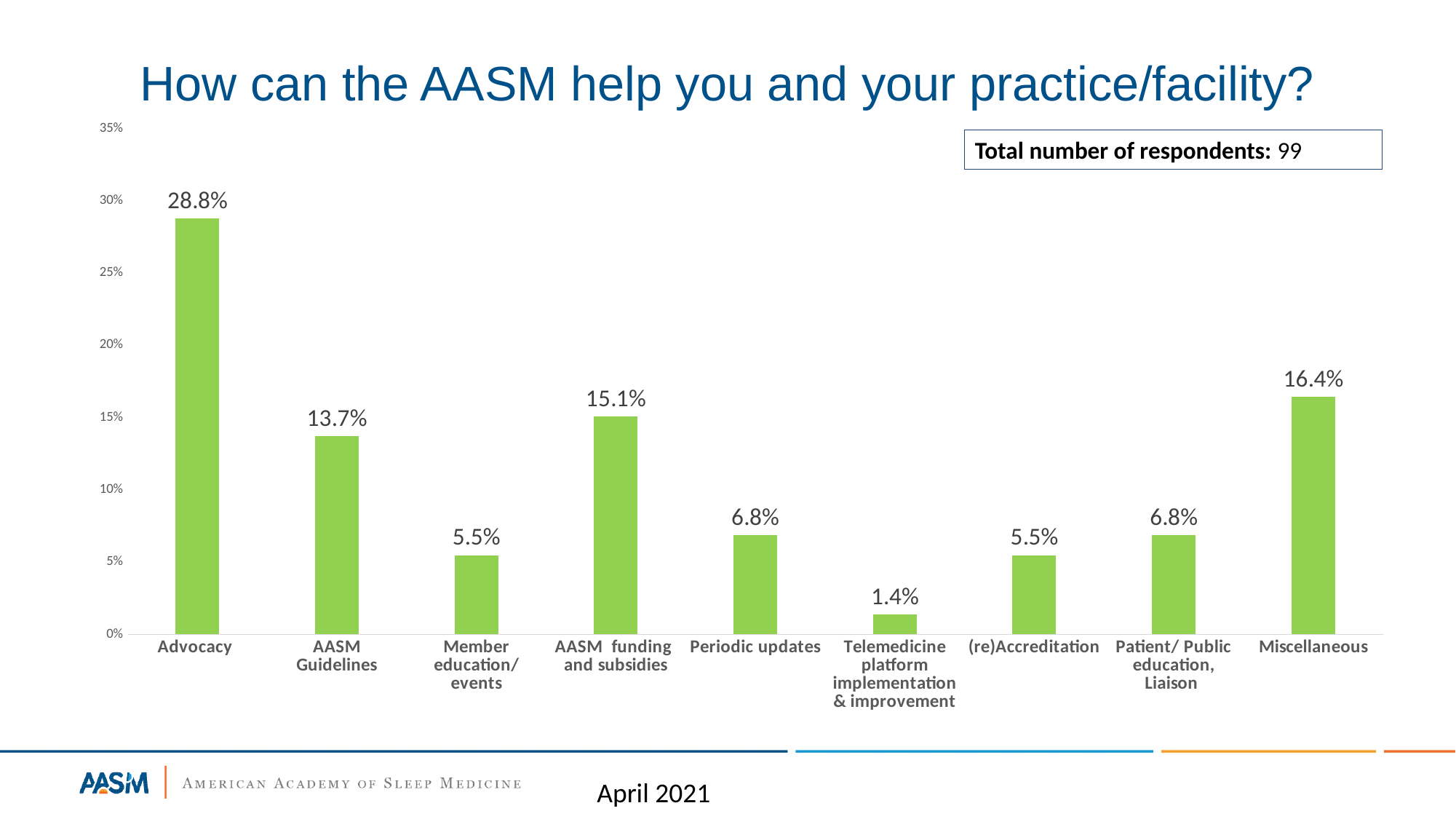
What is the value for Advocacy? 28.8% What is the difference between the values for Advocacy and AASM Guidelines? 15.1% What is the total number of respondents stated on the slide? 99 What is the value for Miscellaneous? 16.4% Which category has the highest value? Advocacy What is the value for Telemedicine platform implementation & improvement? 1.4% Which is larger, the value for Miscellaneous or the value for AASM funding and subsidies? Miscellaneous What is the value for AASM funding and subsidies? 15.1% What kind of chart is shown on the slide? bar chart Which category has the lowest value? Telemedicine platform implementation & improvement Is the value for Periodic updates greater or less than 10%? less How many categories are shown in the chart? 9